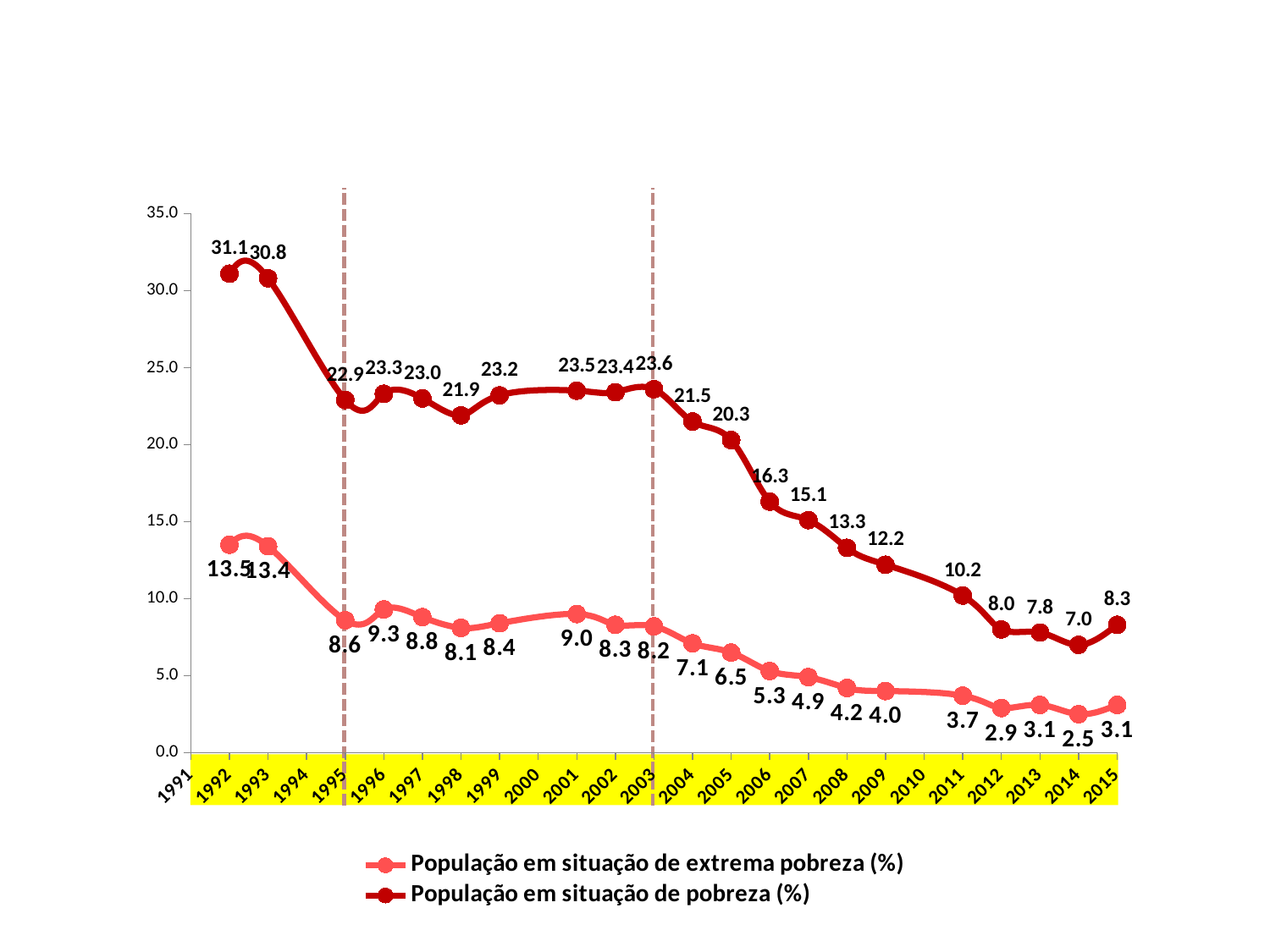
Which is larger: População em situação de pobreza (%) in 2003 or in 2004? 2003 What is the value of População em situação de pobreza (%) in 2006? 16.3 In which year is População em situação de pobreza (%) at its lowest? 2014 Does População em situação de pobreza (%) generally rise or fall from 2003 to 2014? Fall What is the value of População em situação de pobreza (%) in 1992? 31.1 In which year is População em situação de extrema pobreza (%) at its highest? 1992 What is the difference between População em situação de pobreza (%) and População em situação de extrema pobreza (%) in 2015? 5.2 How many series does the legend list? 2 How many data points are plotted for the População em situação de pobreza (%) series? 21 What is the value of População em situação de extrema pobreza (%) in 2014? 2.5 What kind of chart is shown on the slide? Line chart What is the difference between População em situação de extrema pobreza (%) in 1992 and in 1995? 4.9